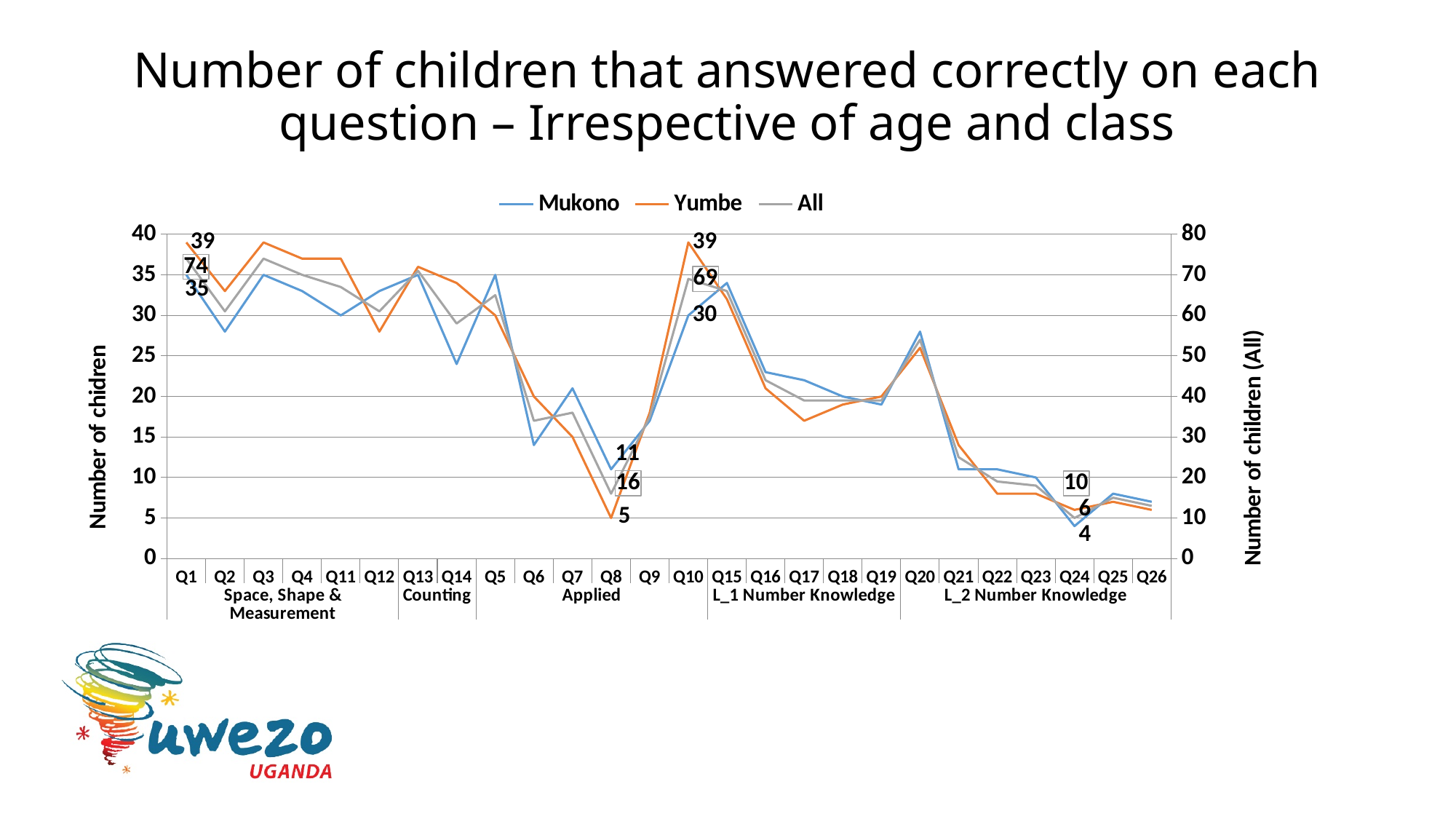
What is the value for Yumbe at Q1? 39 What is the value for Mukono at Q1? 35 What kind of chart is shown on the slide? Line chart What is the value for the All series at Q10? 69 What is the value for Mukono at Q24? 4 At Q10, which series has the larger value, Mukono or Yumbe? Yumbe What is the value for Yumbe at Q8? 5 What is the difference between the Yumbe and Mukono values at Q1? 4 Is the value for Mukono at Q2 greater or less than 30? less What is the difference between the Mukono and Yumbe values at Q8? 6 How many series does the legend list? 3 What is the value for the All series at Q1? 74